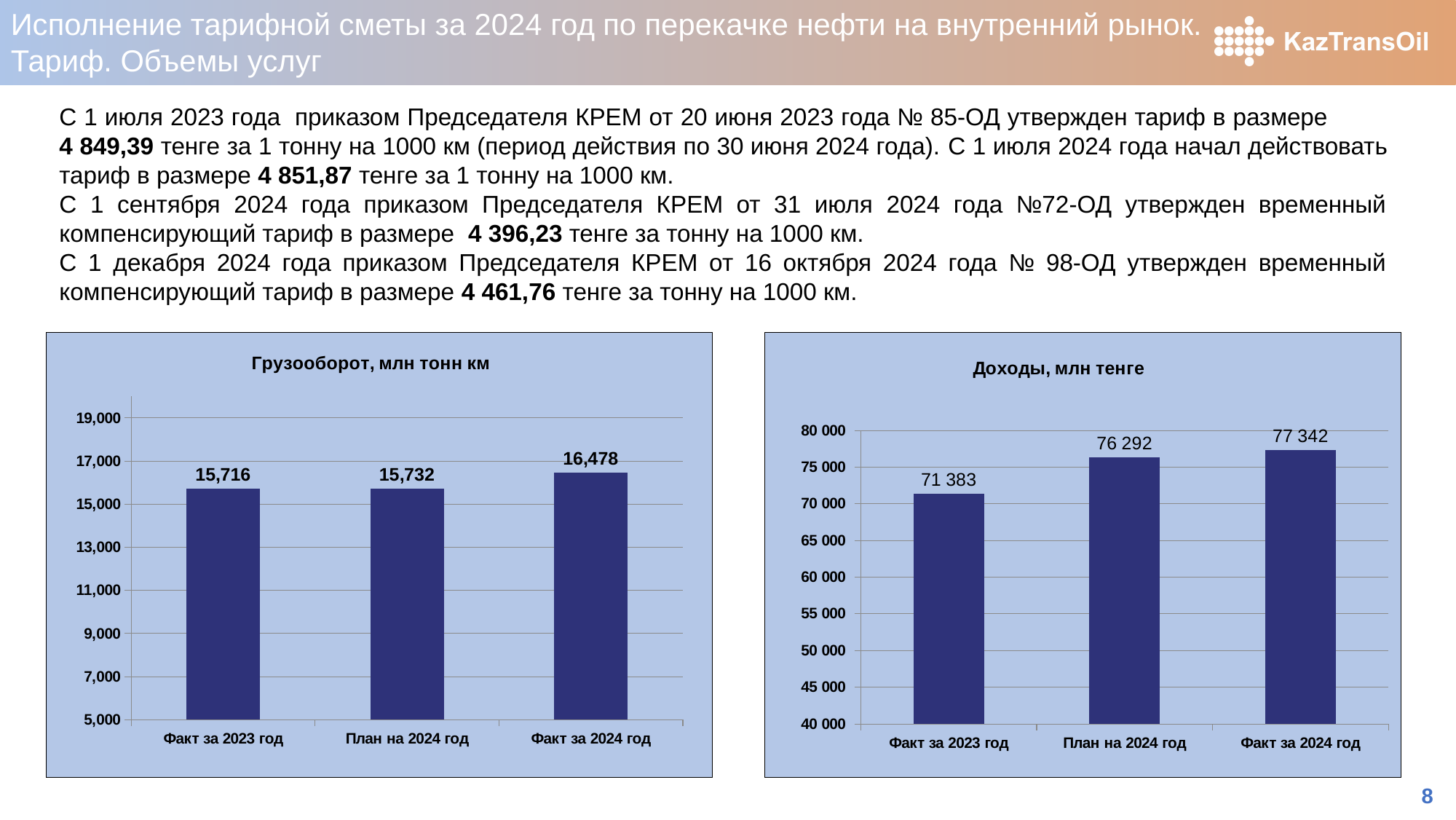
In the chart titled 'Грузооборот, млн тонн км', what is the value for 'Факт за 2024 год'? 16,478 In the chart titled 'Грузооборот, млн тонн км', what is the value for 'План на 2024 год'? 15,732 What kind of chart is the chart titled 'Доходы, млн тенге'? bar chart In the chart titled 'Доходы, млн тенге', do the values rise or fall from left to right across the categories? rise In the chart titled 'Грузооборот, млн тонн км', what is the difference between 'Факт за 2024 год' and 'План на 2024 год'? 746 In the chart titled 'Грузооборот, млн тонн км', which category has the highest value? Факт за 2024 год In the chart titled 'Доходы, млн тенге', what is the value for 'План на 2024 год'? 76 292 In the chart titled 'Доходы, млн тенге', what is the difference between 'Факт за 2024 год' and 'Факт за 2023 год'? 5 959 In the chart titled 'Доходы, млн тенге', which category has the lowest value? Факт за 2023 год In the chart titled 'Доходы, млн тенге', is the value for 'Факт за 2023 год' greater or less than 75 000? less In the chart titled 'Грузооборот, млн тонн км', how many categories are shown? 3 In the chart titled 'Доходы, млн тенге', what is the value for 'Факт за 2023 год'? 71 383